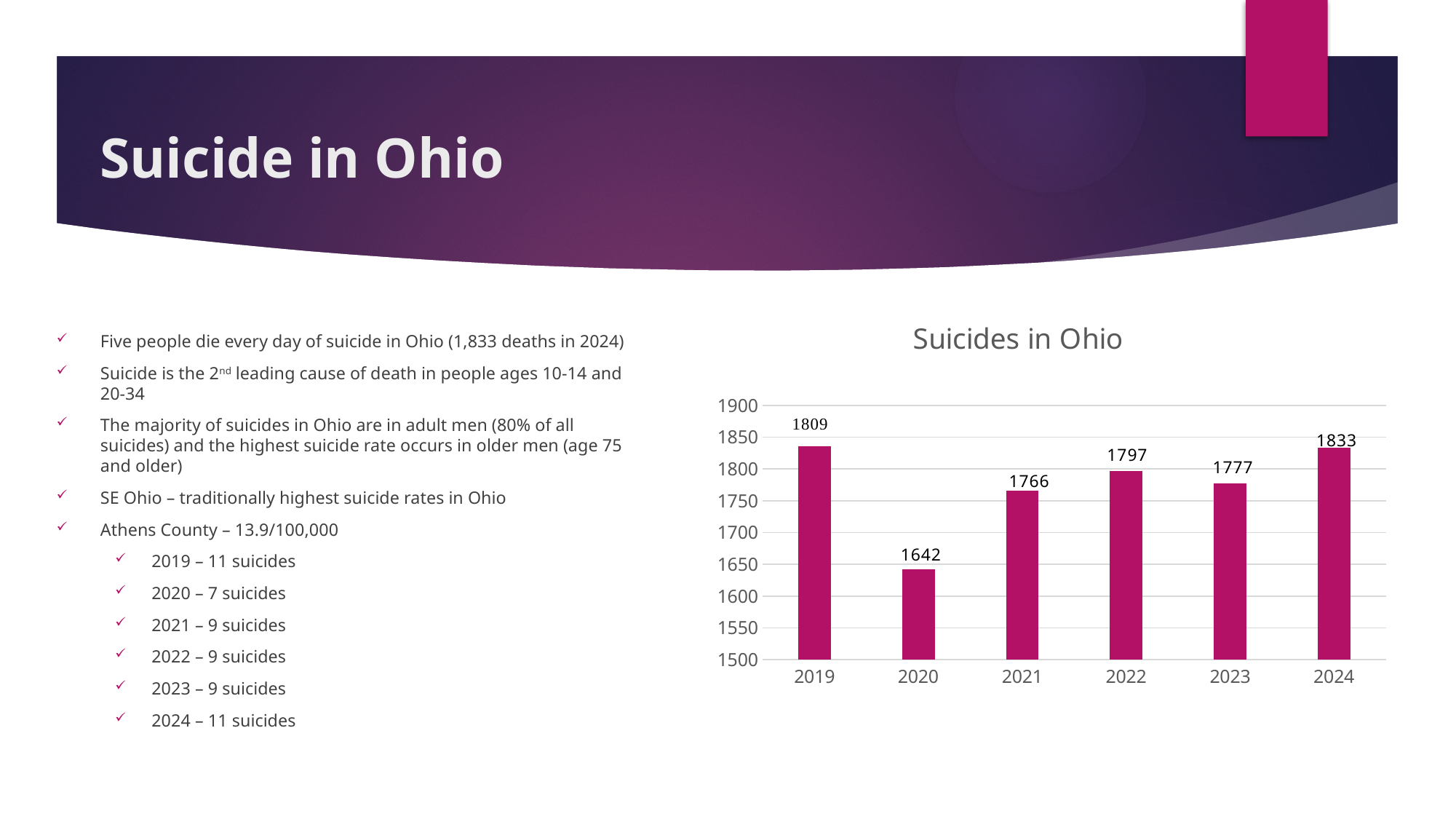
How many years are shown in the Suicides in Ohio chart? 6 What is the difference between the values for 2019 and 2020 in the Suicides in Ohio chart? 167 What is the value for 2020 in the Suicides in Ohio chart? 1642 Is the value for 2020 in the Suicides in Ohio chart greater or less than 1700? less What is the difference between the values for 2024 and 2023 in the Suicides in Ohio chart? 56 Which year has the lowest value in the Suicides in Ohio chart? 2020 What is the value for 2022 in the Suicides in Ohio chart? 1797 What is the value for 2019 in the Suicides in Ohio chart? 1809 What kind of chart is the Suicides in Ohio chart? bar chart Which is larger in the Suicides in Ohio chart, the value for 2021 or the value for 2023? 2023 What is the title of the chart on the slide? Suicides in Ohio